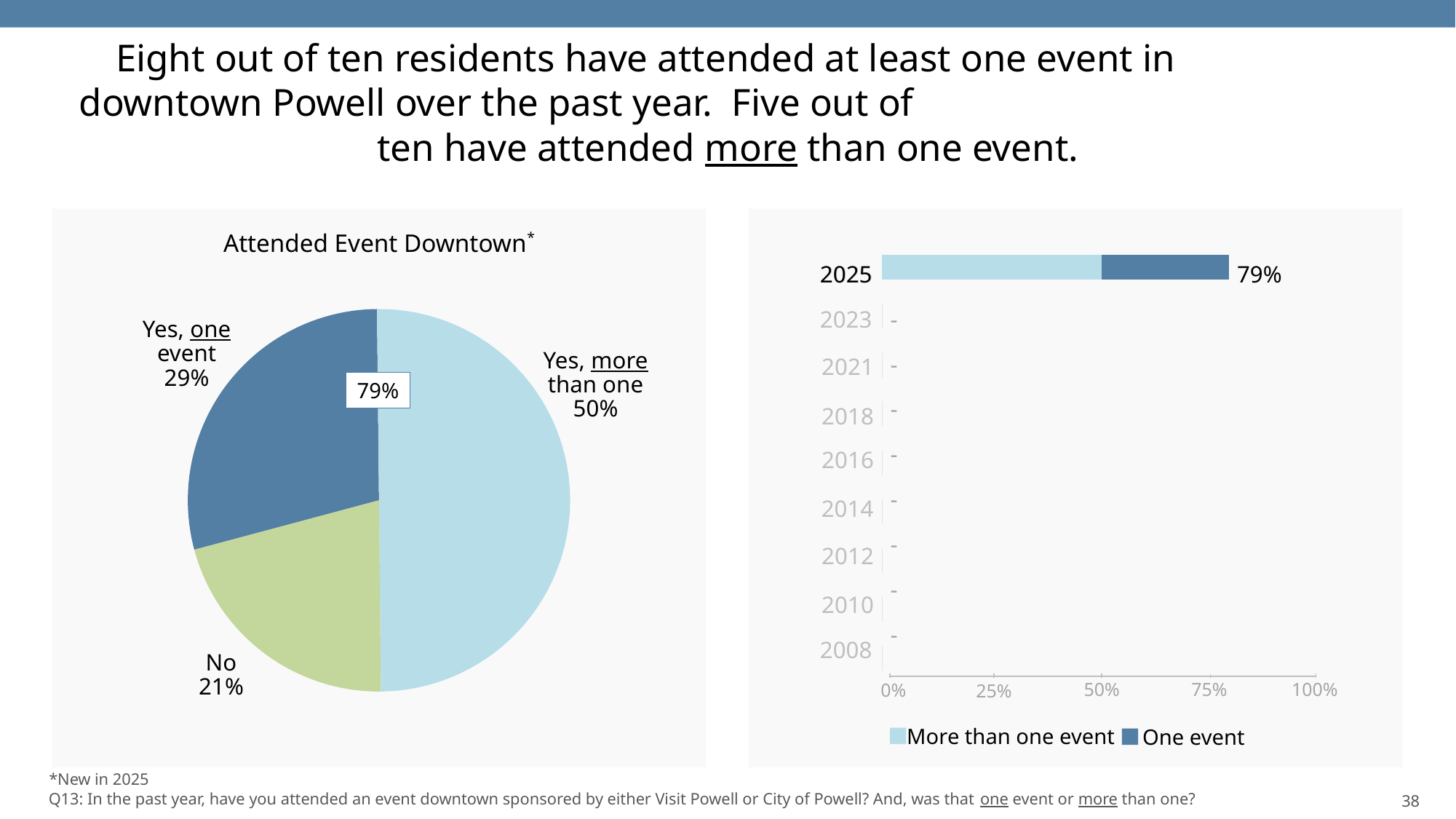
What kind of chart is the chart on the left side of the slide? Pie chart In the bar chart on the right, what is the total labelled for the 2025 bar? 79% In the bar chart on the right, how many series does the legend list? 2 In the pie chart titled "Attended Event Downtown", which slice is the smallest? No In the pie chart titled "Attended Event Downtown", what share of residents answered "Yes, more than one"? 50% In the pie chart titled "Attended Event Downtown", what share of residents answered "No"? 21% What kind of chart is the chart on the right side of the slide? Bar chart In the pie chart titled "Attended Event Downtown", what is the difference in percentage points between the "Yes, more than one" slice and the "No" slice? 29 percentage points In the bar chart on the right, which year is the only one with a plotted bar? 2025 In the pie chart titled "Attended Event Downtown", what share of residents answered "Yes, one event"? 29% In the pie chart titled "Attended Event Downtown", which slice is the largest? Yes, more than one In the pie chart titled "Attended Event Downtown", how many slices are there? 3